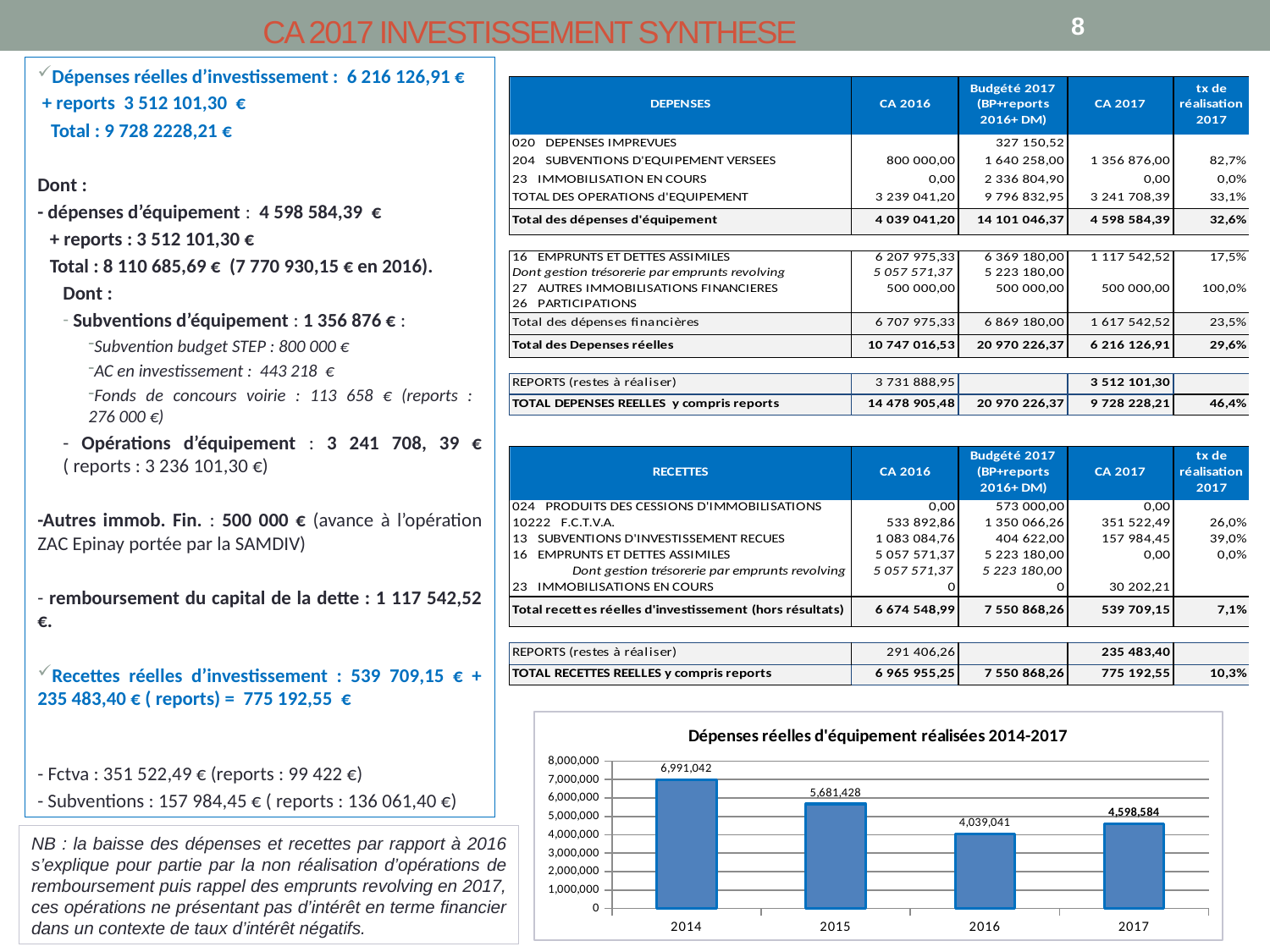
What is the difference between the values for 2014 and 2015? 1,309,614 What is the title of the chart? Dépenses réelles d'équipement réalisées 2014-2017 What is the value for 2017 in the chart? 4,598,584 Which year has the lowest value in the chart? 2016 Which is larger, the value for 2016 or the value for 2017? 2017 Which year has the highest value in the chart? 2014 What kind of chart is shown on the slide? bar chart Is the value for 2015 greater or less than 5,000,000? greater How many years are shown in the chart? 4 What is the difference between the values for 2017 and 2016? 559,543 What is the value for 2014 in the chart? 6,991,042 What is the value for 2015 in the chart? 5,681,428